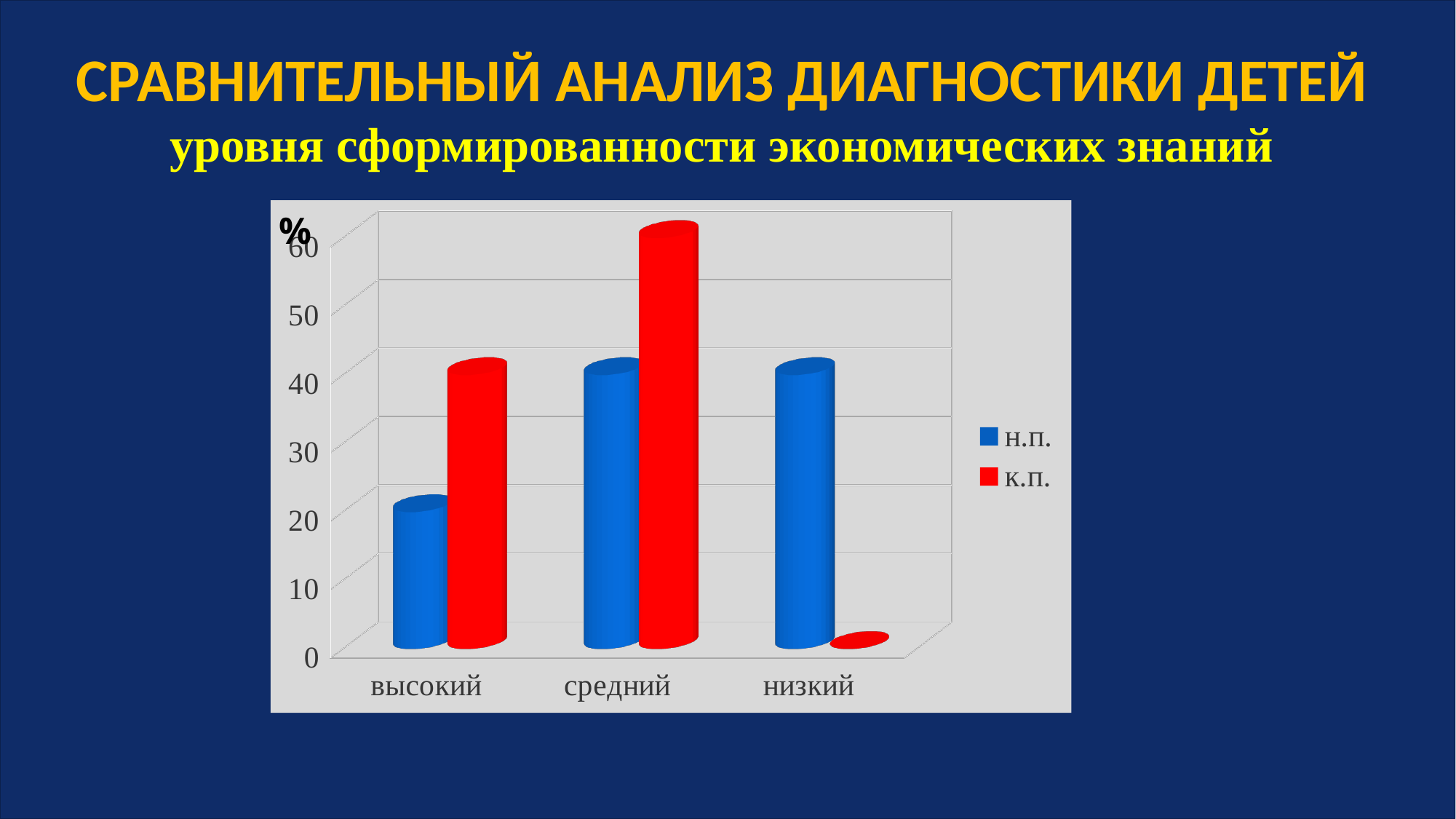
For the н.п. series, which category has the lowest value? высокий How many series does the chart legend list? 2 For the к.п. series, which category has the lowest value? низкий For the к.п. series, which category has the highest value? средний Is the value for к.п. in the средний category greater or less than 50? greater In the низкий category, which series has the larger value, н.п. or к.п.? н.п. Which series is shown in red in the chart? к.п. How many categories are shown on the x axis of the chart? 3 Is the value for н.п. in the высокий category greater or less than 30? less What unit is indicated on the vertical axis of the chart? % What kind of chart is shown on the slide? bar chart In the высокий category, which series has the larger value, н.п. or к.п.? к.п.